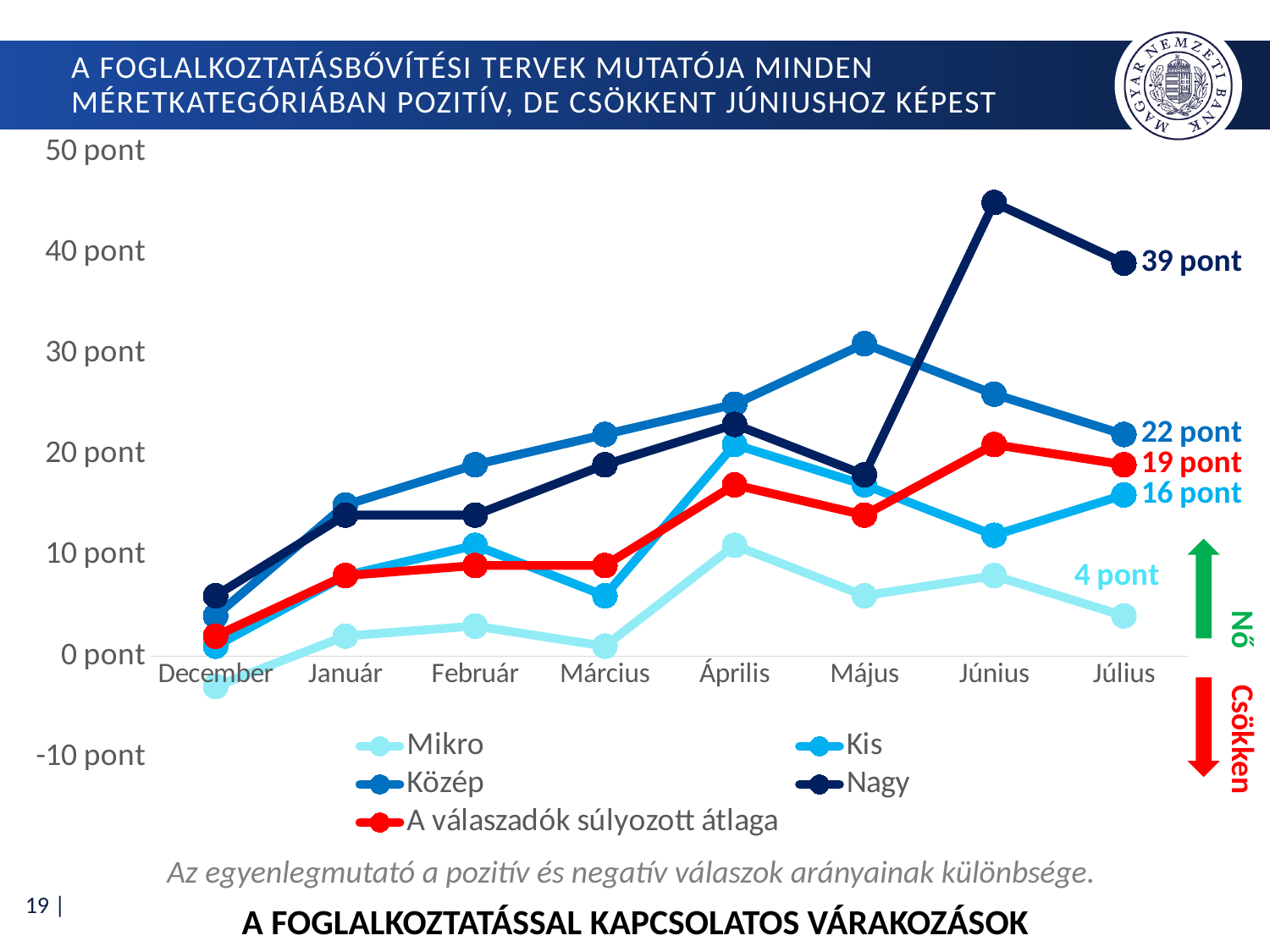
Which is larger in Július, the value for Kis or the value for Mikro? Kis What is the value for Mikro in Július? 4 pont What kind of chart is shown on the slide? line chart What is the difference between the Nagy and Közép values in Július? 17 pont What is the value for A válaszadók súlyozott átlaga in Július? 19 pont Is the value for Nagy in Június greater or less than 40 pont? greater How many months are shown on the x axis? 8 Which series has the highest value in Július? Nagy Which series has the lowest value in Július? Mikro What is the value for Közép in Július? 22 pont What is the value for Nagy in Július? 39 pont How many series does the legend list? 5